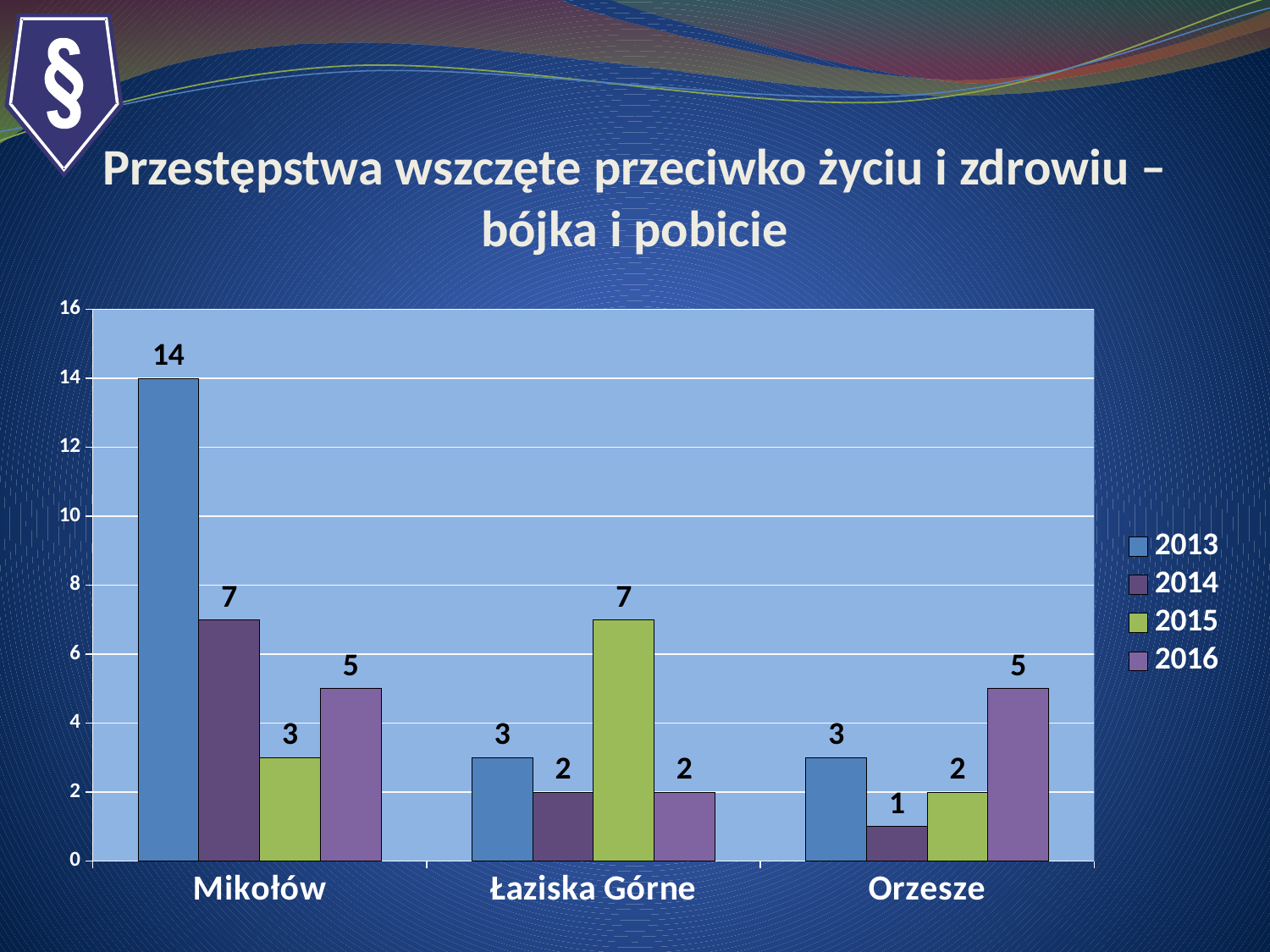
How many series does the legend list? 4 Which category has the highest value in the 2013 series? Mikołów What is the value for Orzesze in 2014? 1 Is the value for Mikołów in 2013 greater or less than 12? greater What kind of chart is shown on the slide? bar chart Which category has the lowest value in the 2014 series? Orzesze Which is larger: the 2016 value for Łaziska Górne or the 2016 value for Orzesze? Orzesze What is the value for Łaziska Górne in 2015? 7 What is the difference between the 2013 and 2014 values for Mikołów? 7 What is the value for Mikołów in 2013? 14 What is the title of the chart? Przestępstwa wszczęte przeciwko życiu i zdrowiu – bójka i pobicie How many categories are shown on the x axis? 3